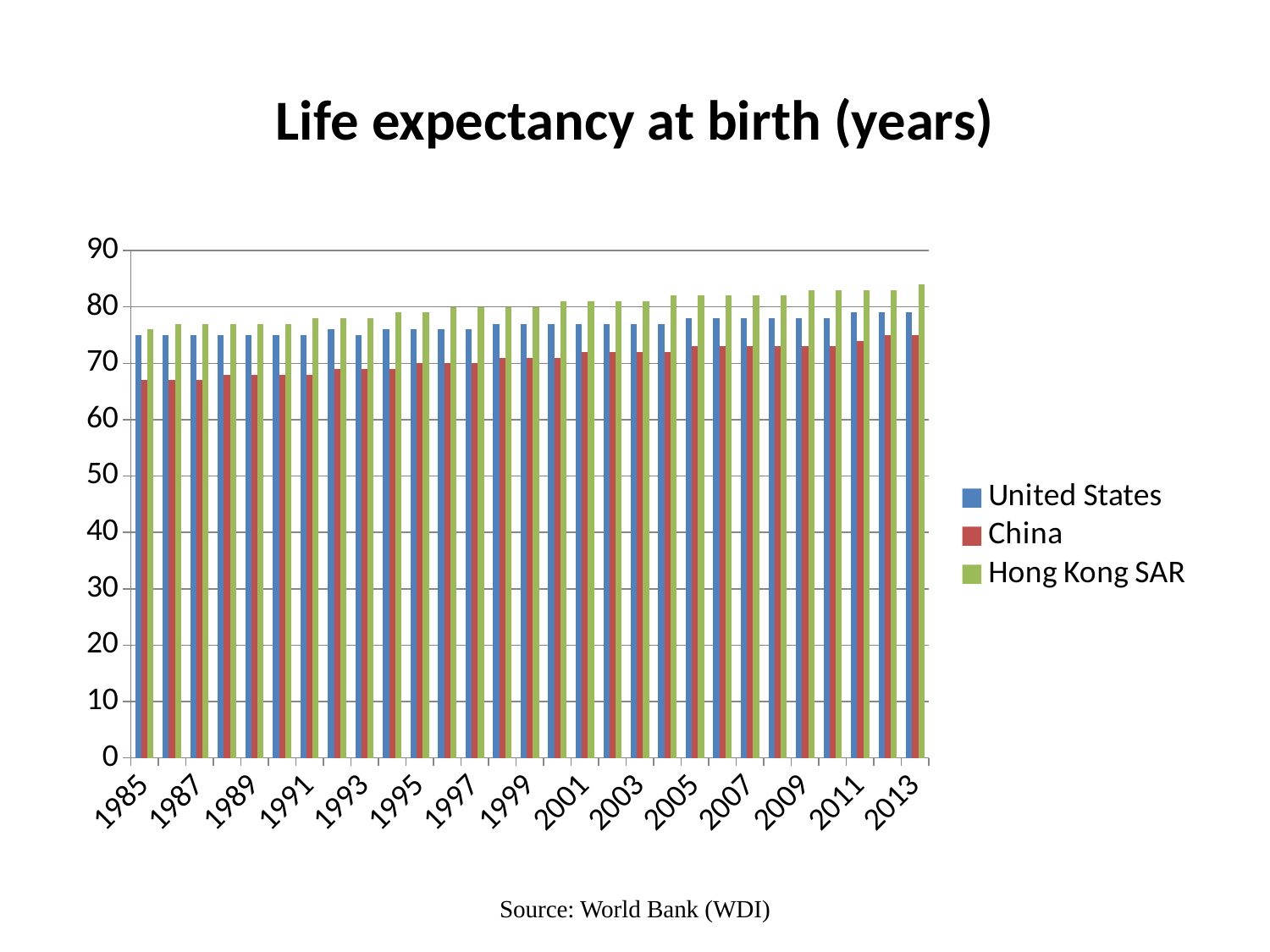
Is the value for Hong Kong SAR in 2013 greater or less than 80? greater What is the title of the chart? Life expectancy at birth (years) Is the value for China in 1985 greater or less than 70? less In 1985, which is larger: the value for China or the value for the United States? United States What type of chart is shown on the slide? bar chart Which series is shown in green? Hong Kong SAR Which series has the lowest life expectancy in 1985? China How many series does the legend list? 3 Is the value for the United States in 1985 greater or less than 70? greater Which series has the highest life expectancy in 2013? Hong Kong SAR In 2013, which is larger: the value for the United States or the value for Hong Kong SAR? Hong Kong SAR Do the values for China rise or fall from 1985 to 2013? rise